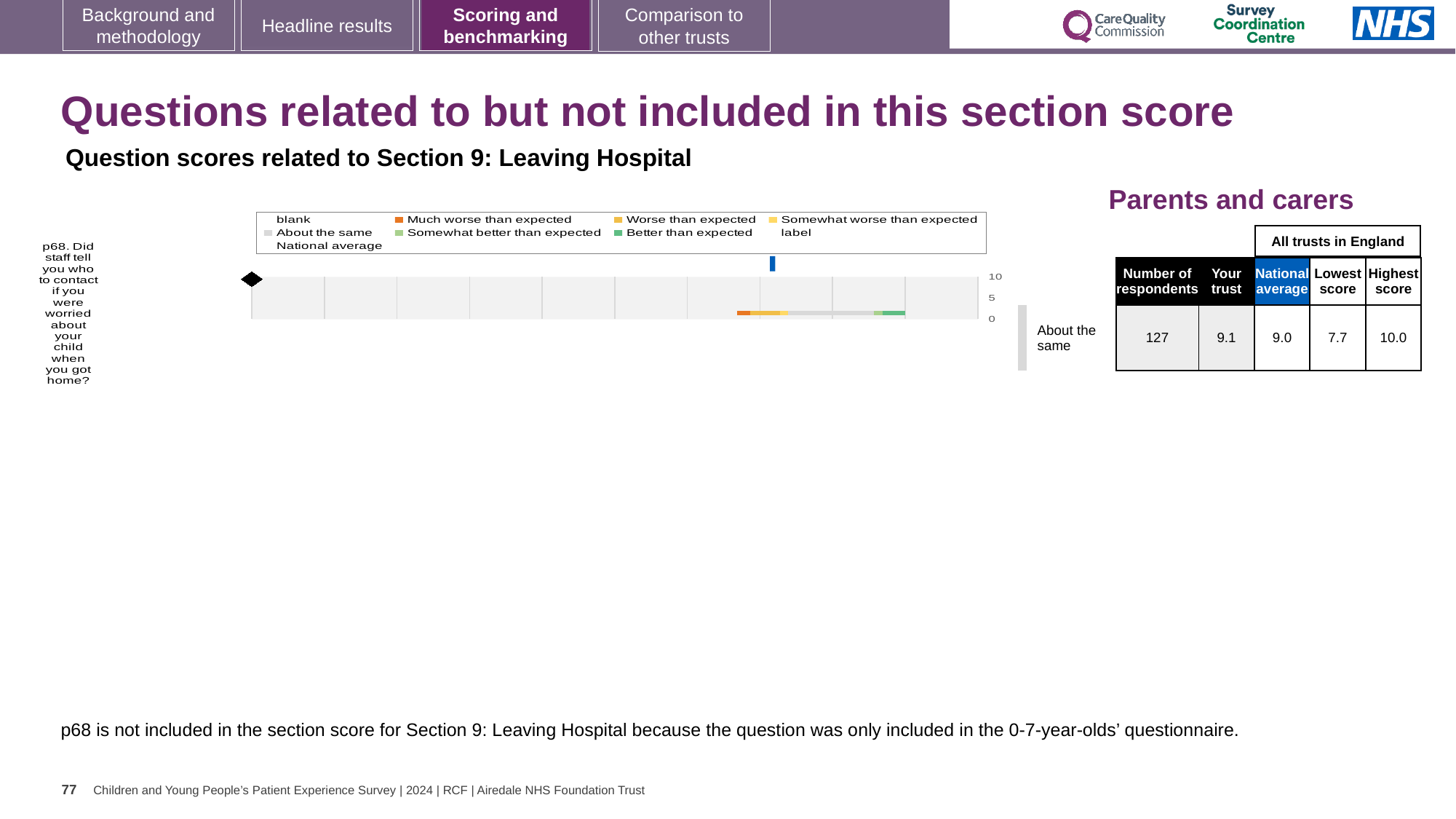
What is the highest score among all trusts in England for p68? 10.0 What is the difference between the highest score and the lowest score for p68? 2.3 How many respondents answered p68? 127 What is the lowest score among all trusts in England for p68? 7.7 What is the national average score for p68? 9.0 What kind of chart is used to show the p68 question score? bar chart Which is larger for p68, the 'Your trust' score or the national average? Your trust How many questions are plotted in the chart? 1 What is the highest value shown on the chart's axis? 10 What is the 'Your trust' score for p68? 9.1 How is the trust's result for p68 categorised relative to expectations? About the same Which question is plotted in the chart? p68. Did staff tell you who to contact if you were worried about your child when you got home?